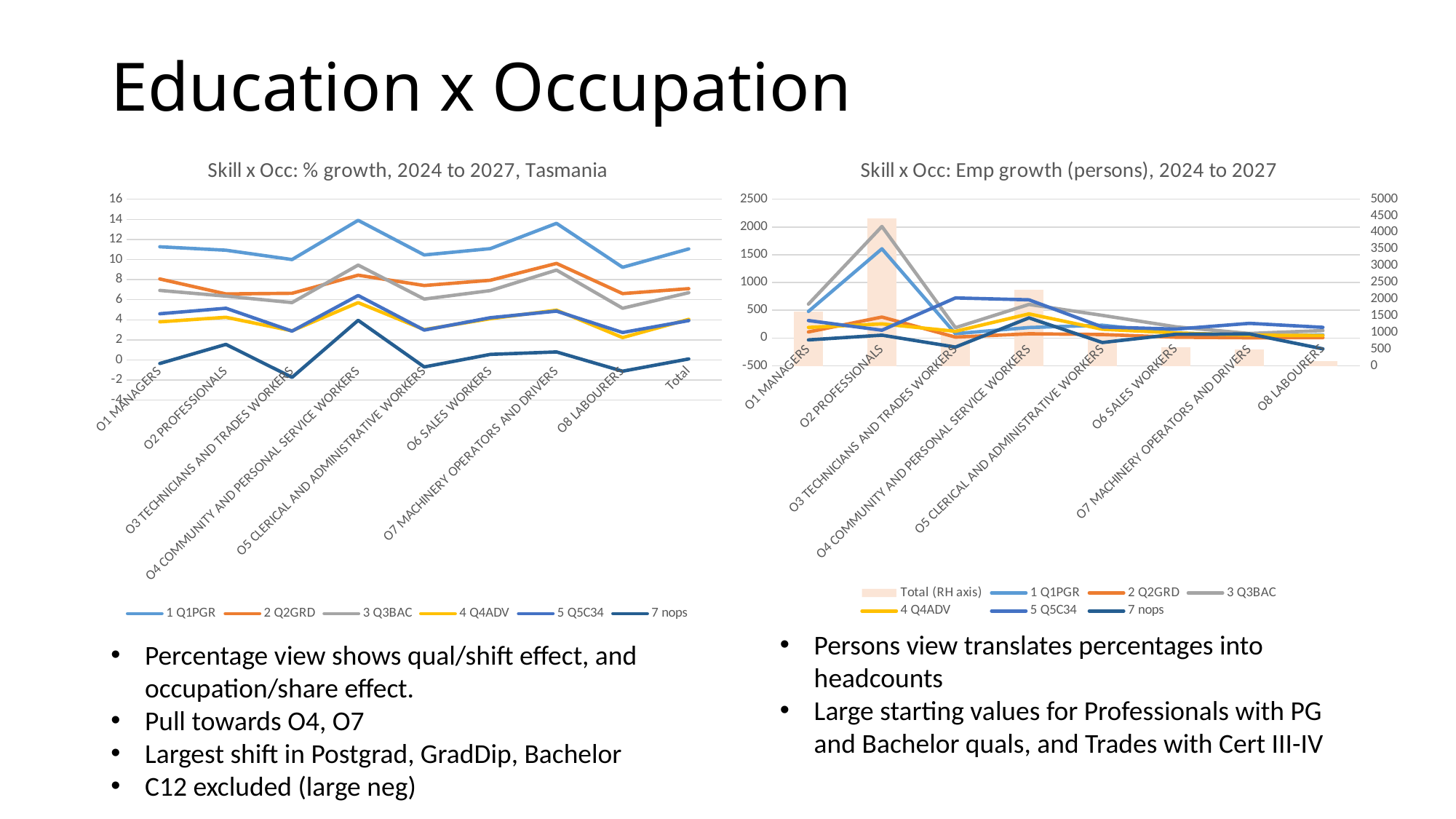
How many series does the legend of the left chart, 'Skill x Occ: % growth, 2024 to 2027, Tasmania', list? 6 In the left chart, 'Skill x Occ: % growth, 2024 to 2027, Tasmania', is the value of 7 nops for O3 Technicians and Trades Workers greater or less than 0? less In the right chart, 'Skill x Occ: Emp growth (persons), 2024 to 2027', which occupation has the tallest Total (RH axis) bar? O2 Professionals How many categories are shown on the x axis of the left chart, 'Skill x Occ: % growth, 2024 to 2027, Tasmania'? 9 In the left chart, 'Skill x Occ: % growth, 2024 to 2027, Tasmania', which is larger for O1 Managers: 1 Q1PGR or 7 nops? 1 Q1PGR In the left chart, 'Skill x Occ: % growth, 2024 to 2027, Tasmania', which series has the highest values across the occupations? 1 Q1PGR Which series in the right chart, 'Skill x Occ: Emp growth (persons), 2024 to 2027', is plotted against the right-hand axis? Total (RH axis) In the right chart, 'Skill x Occ: Emp growth (persons), 2024 to 2027', is the value of 3 Q3BAC for O2 Professionals greater or less than 1500? greater In the left chart, 'Skill x Occ: % growth, 2024 to 2027, Tasmania', is the value of 1 Q1PGR for O4 Community and Personal Service Workers greater or less than 12? greater What kind of chart is the left chart, 'Skill x Occ: % growth, 2024 to 2027, Tasmania'? Line chart In the left chart, 'Skill x Occ: % growth, 2024 to 2027, Tasmania', at which occupation does the 1 Q1PGR series reach its highest value? O4 Community and Personal Service Workers How many series does the legend of the right chart, 'Skill x Occ: Emp growth (persons), 2024 to 2027', list? 7